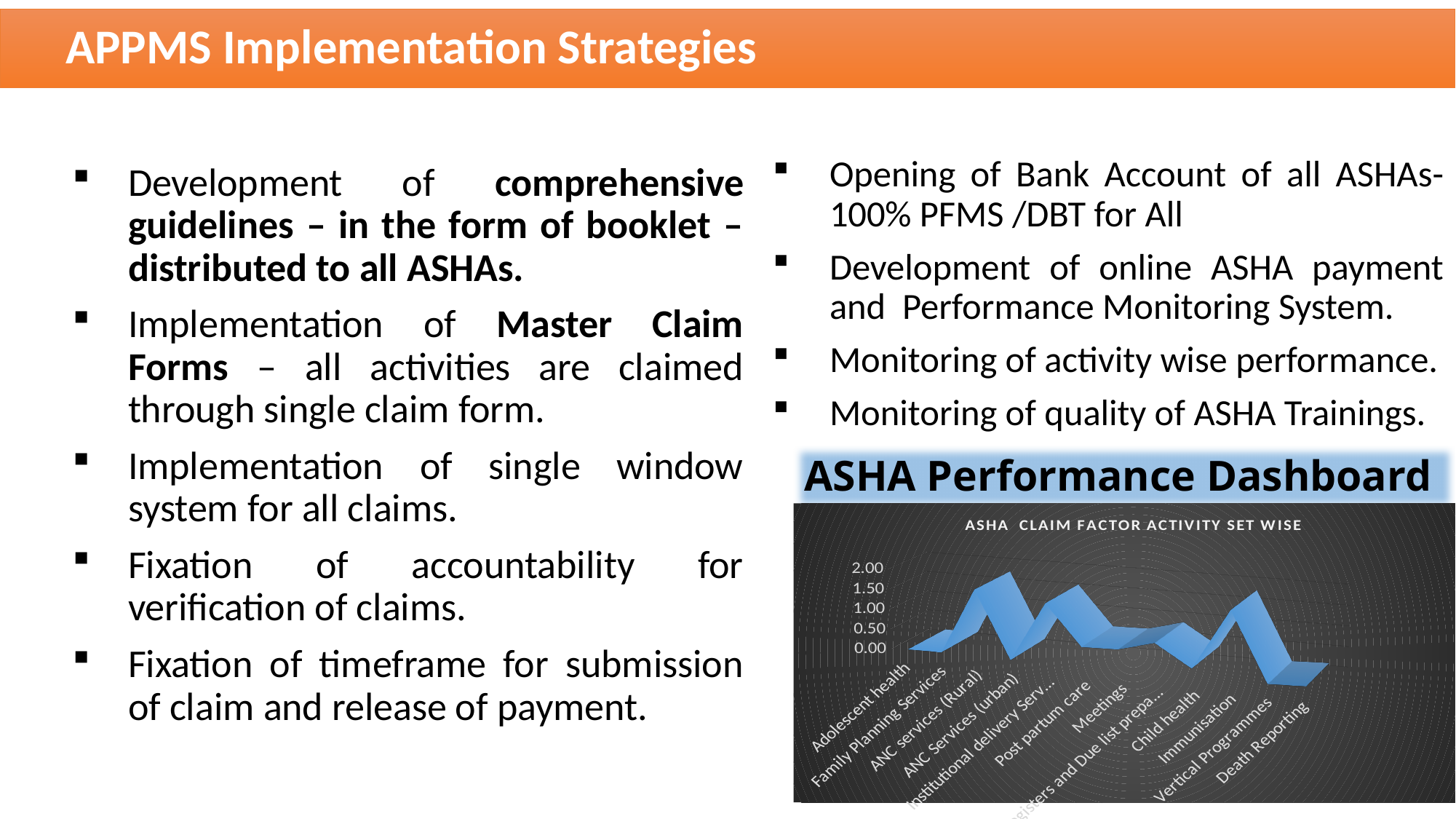
How many activity categories are plotted along the x axis of the chart? 12 Which has the larger value, ANC services (Rural) or Adolescent health? ANC services (Rural) Which is the first activity category listed on the x axis of the chart? Adolescent health Which has the larger value, Immunisation or Death Reporting? Immunisation Is the value for Death Reporting greater or less than 1.00? less What is the highest value shown on the vertical axis of the chart? 2.00 Is the value for Adolescent health greater or less than 0.50? less Is the value for Immunisation greater or less than 1.00? greater What is the title of the chart on the slide? ASHA CLAIM FACTOR ACTIVITY SET WISE What kind of chart is shown under the ASHA Performance Dashboard heading? 3D line chart